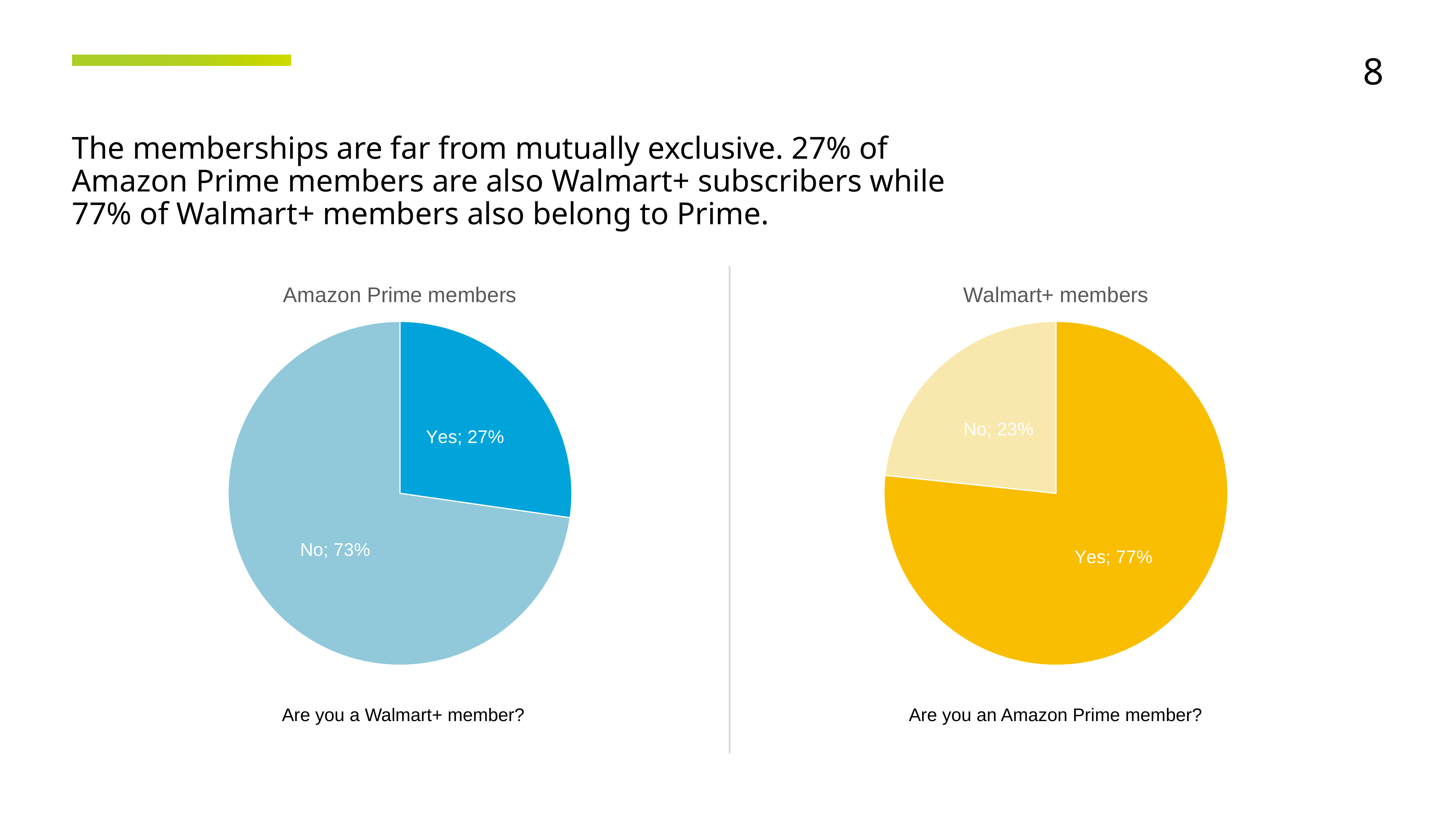
In the 'Walmart+ members' pie chart, which slice is the smallest? No In the 'Amazon Prime members' pie chart, which slice is the largest? No In the 'Amazon Prime members' pie chart, what share of respondents answered Yes? 27% How many slices does the 'Amazon Prime members' pie chart have? 2 In the 'Walmart+ members' pie chart, what share of respondents answered No? 23% In the 'Amazon Prime members' pie chart, what is the difference between the No and Yes shares? 46% What question is shown beneath the 'Walmart+ members' pie chart? Are you an Amazon Prime member? In the 'Walmart+ members' pie chart, what share of respondents answered Yes? 77% What type of chart is used for 'Walmart+ members'? Pie chart In the 'Walmart+ members' pie chart, what is the difference between the Yes and No shares? 54% Which is larger: the Yes share in the 'Amazon Prime members' chart or the Yes share in the 'Walmart+ members' chart? Walmart+ members In the 'Amazon Prime members' pie chart, what share of respondents answered No? 73%